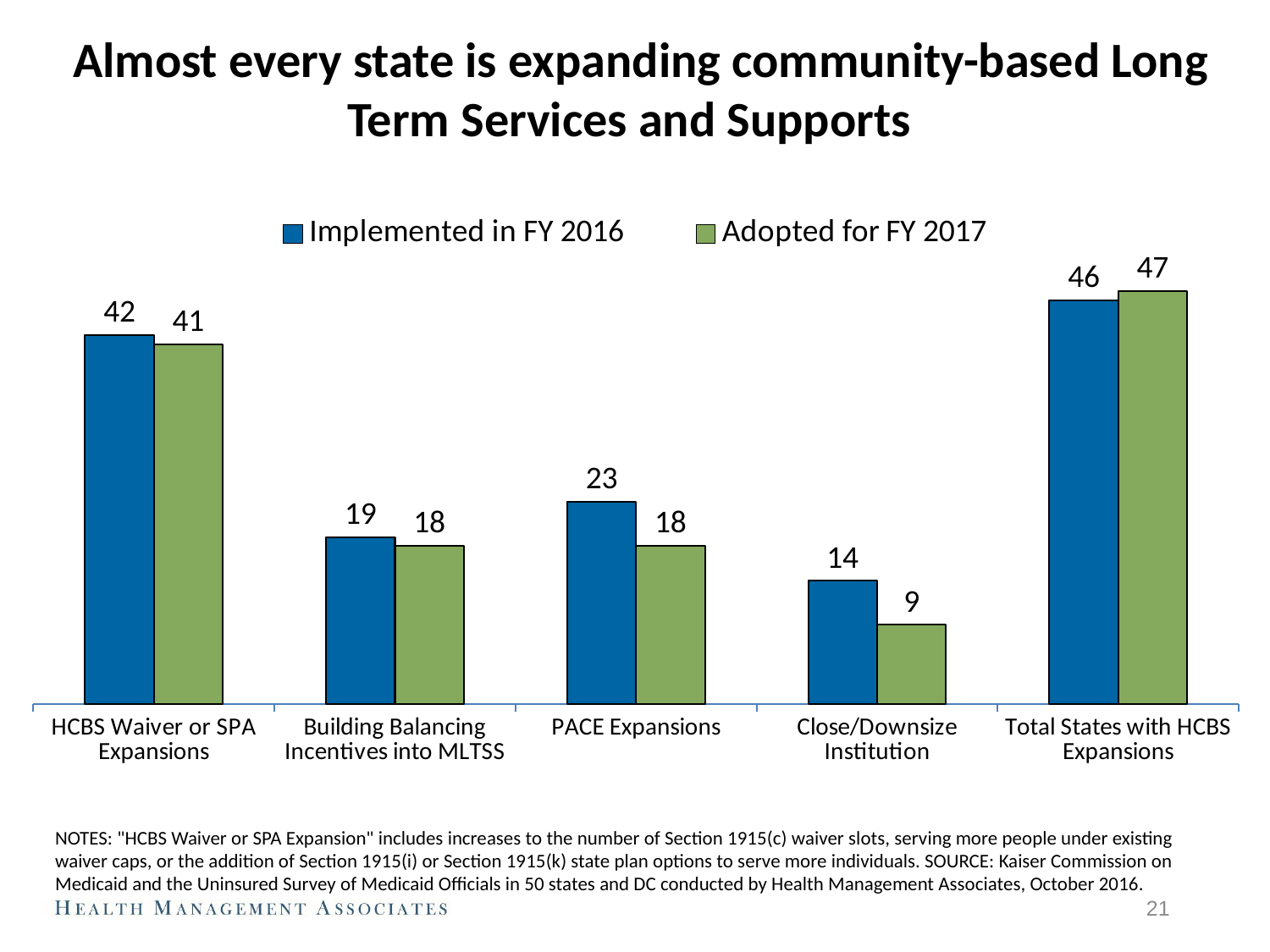
Which category has the lowest value in the Adopted for FY 2017 series? Close/Downsize Institution How many categories are shown on the x axis of the chart? 5 What is the difference between the Implemented in FY 2016 values for HCBS Waiver or SPA Expansions and PACE Expansions? 19 What is the value for PACE Expansions in the Implemented in FY 2016 series? 23 What is the value for Close/Downsize Institution in the Adopted for FY 2017 series? 9 For Building Balancing Incentives into MLTSS, which series has the larger value: Implemented in FY 2016 or Adopted for FY 2017? Implemented in FY 2016 What kind of chart is shown on the slide? Bar chart What is the value for Total States with HCBS Expansions in the Adopted for FY 2017 series? 47 How many series does the legend list? 2 Which category has the highest value in the Implemented in FY 2016 series? Total States with HCBS Expansions What is the difference between the Implemented in FY 2016 and Adopted for FY 2017 values for Close/Downsize Institution? 5 What colour are the bars for the Adopted for FY 2017 series? Green